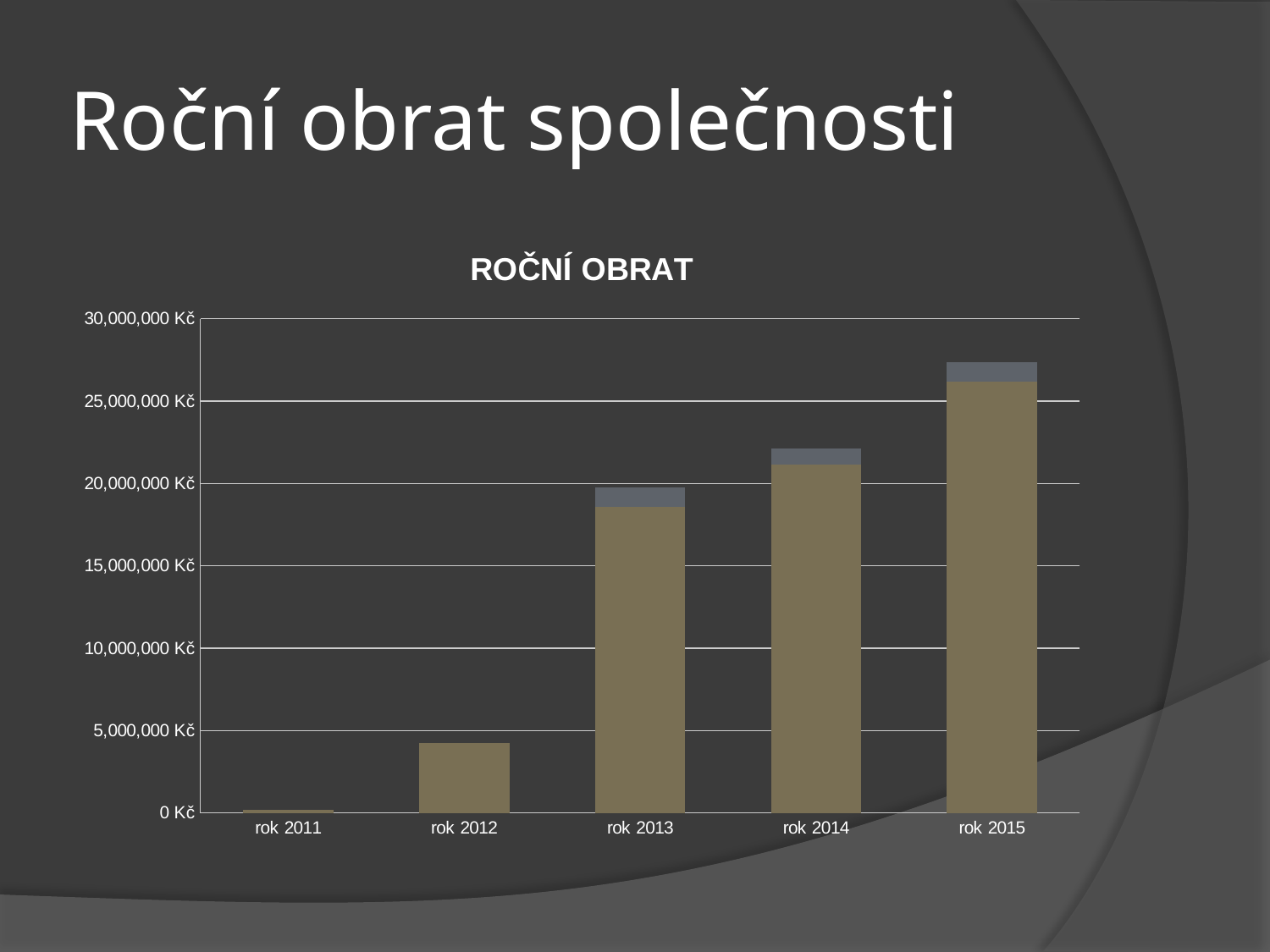
Is the total value for rok 2012 greater or less than 5,000,000 Kč? less Which is larger, the total bar for rok 2012 or for rok 2011? rok 2012 Which year has the lowest total bar in the chart? rok 2011 Is the total value for rok 2015 greater or less than 25,000,000 Kč? greater Do the bar values rise or fall from rok 2011 to rok 2015? rise Which is larger, the total bar for rok 2013 or for rok 2014? rok 2014 What is the title of the chart? ROČNÍ OBRAT How many years (categories) are shown on the x axis of the chart? 5 Is the total value for rok 2014 greater or less than 20,000,000 Kč? greater Which year has the highest total bar in the chart? rok 2015 What kind of chart is shown on the slide? bar chart